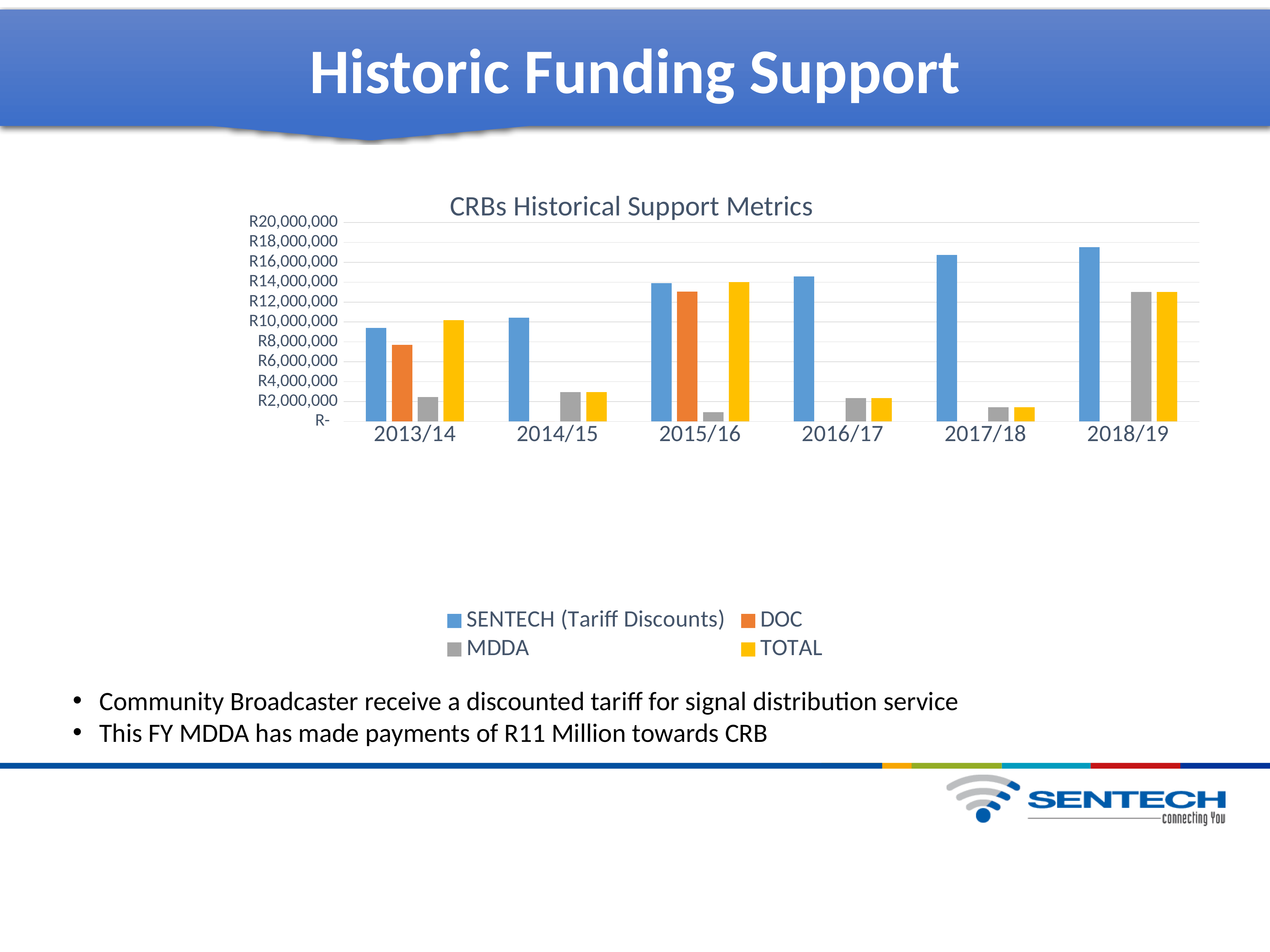
Is the SENTECH (Tariff Discounts) value for 2017/18 greater or less than R16,000,000? greater Does the SENTECH (Tariff Discounts) value rise or fall from 2013/14 to 2018/19? rise Is the DOC value for 2015/16 greater or less than R12,000,000? greater How many series does the legend of the CRBs Historical Support Metrics chart list? 4 What is the title of the chart on the slide? CRBs Historical Support Metrics In 2013/14, which is larger: the SENTECH (Tariff Discounts) value or the DOC value? SENTECH (Tariff Discounts) In 2018/19, which is larger: the SENTECH (Tariff Discounts) value or the MDDA value? SENTECH (Tariff Discounts) Is the MDDA value for 2018/19 greater or less than R12,000,000? greater What colour represents the TOTAL series in the chart? yellow What kind of chart is shown on the slide? bar chart In which financial year is the SENTECH (Tariff Discounts) value highest? 2018/19 How many financial years are shown on the x axis of the chart? 6